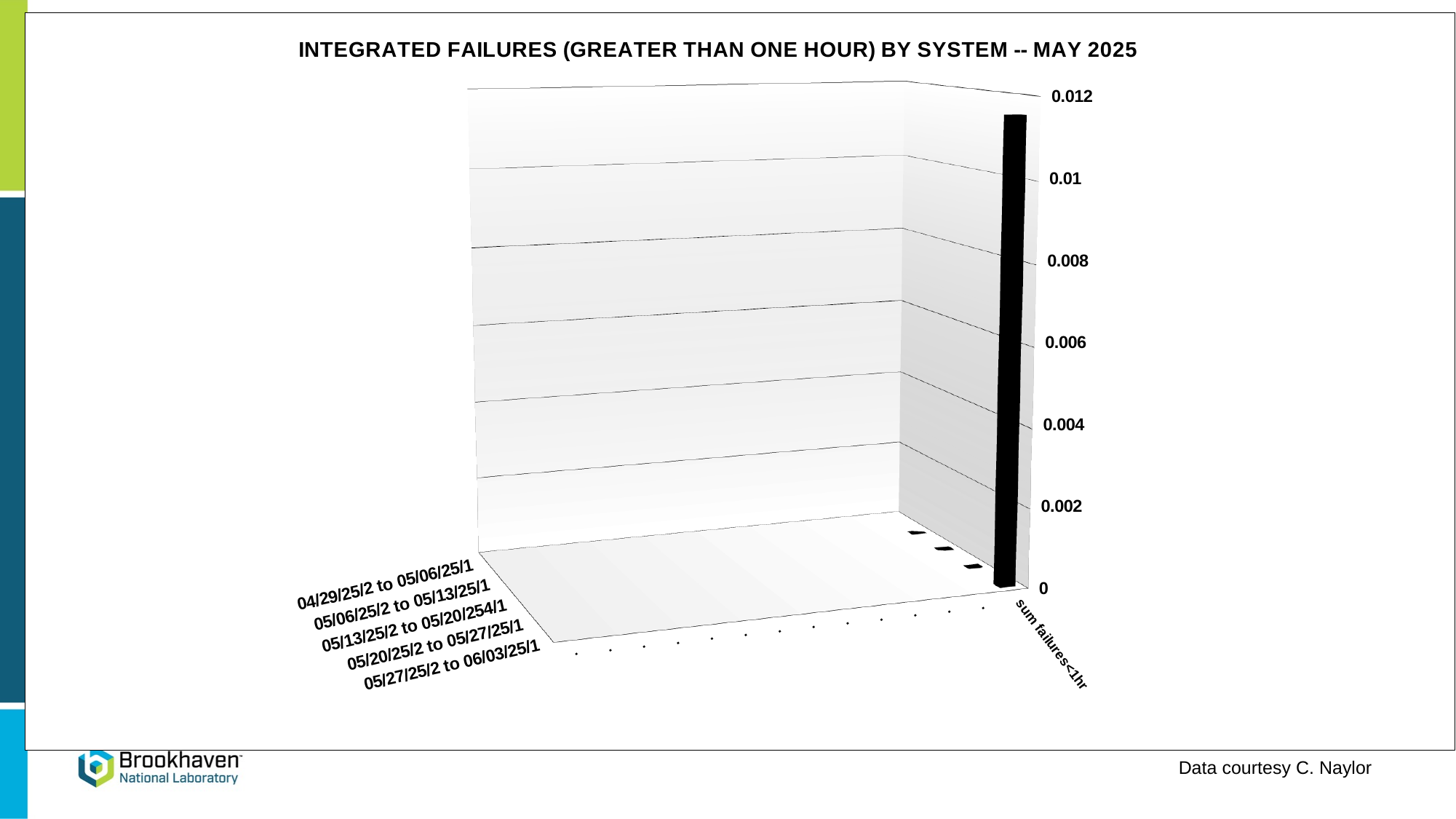
What is the highest value labelled on the vertical axis of the chart? 0.012 Which weekly date range contains the tallest bar in the chart? 05/27/25/2 to 06/03/25/1 What is the title of the chart? INTEGRATED FAILURES (GREATER THAN ONE HOUR) BY SYSTEM -- MAY 2025 What kind of chart is shown on the slide? bar chart How many weekly date ranges are labelled along the date axis of the chart? 5 What is the interval between consecutive tick labels on the vertical axis? 0.002 Is the tallest bar in the chart greater or less than 0.01? greater What is the first (earliest) date range labelled on the date axis? 04/29/25/2 to 05/06/25/1 Is the tallest bar in the chart greater or less than 0.012? less Which system label is readable at the front of the system axis, where the tallest bar is located? sum failures<1hr What is the lowest value labelled on the vertical axis of the chart? 0